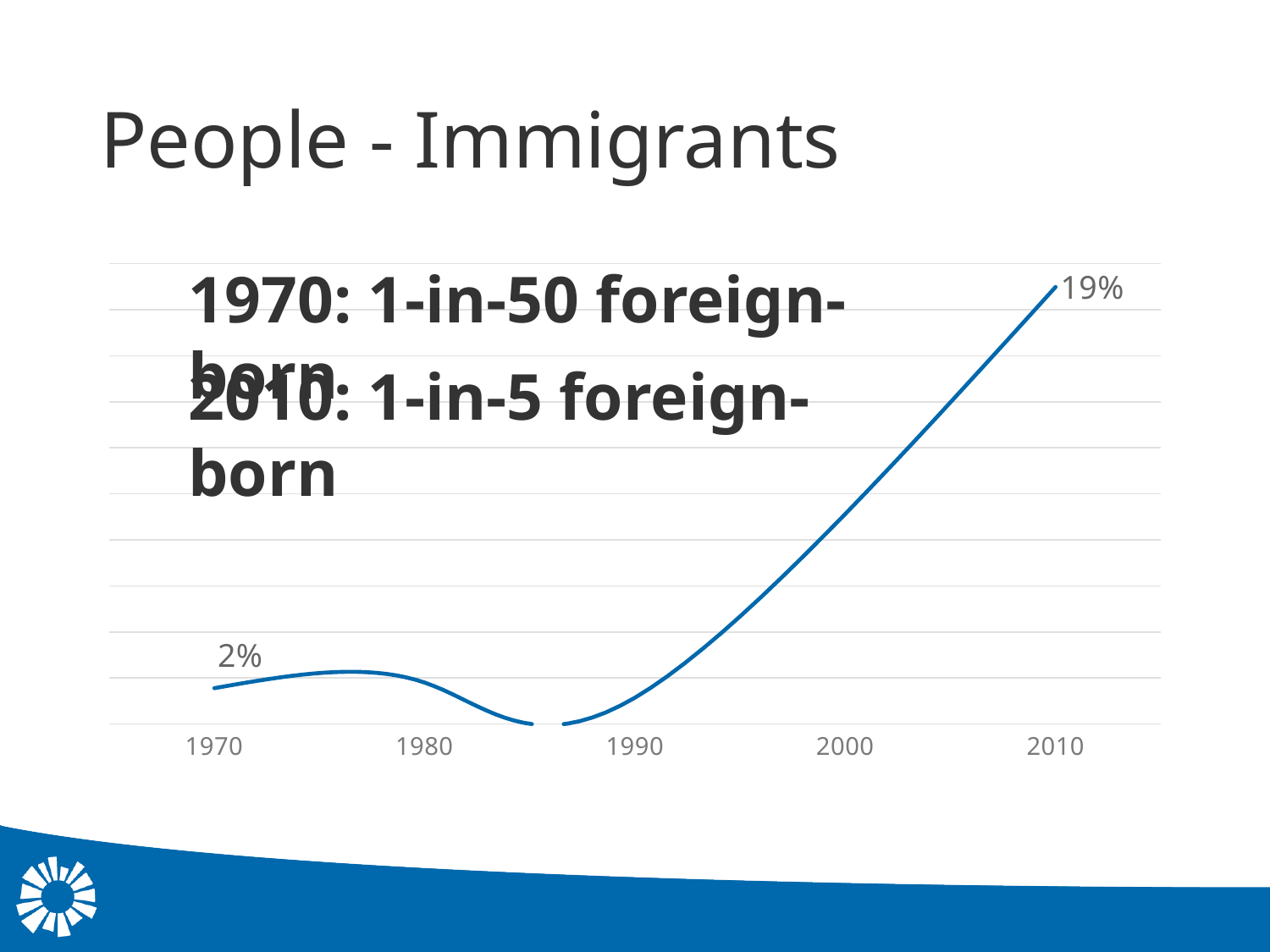
Which is larger, the value for 1970 or the value for 2010? 2010 What kind of chart is shown on the slide? Line chart What is the value shown for 2010? 19% What is the value shown for 1970? 2% What is the title of the slide containing the chart? People - Immigrants What colour is the line in the chart? Blue What is the difference between the 2010 value and the 1970 value? 17 percentage points Which year on the x axis has the highest value? 2010 How many year labels are shown on the x axis? 5 Do the values rise or fall between 1990 and 2010? Rise Which is lower, the value for 1970 or the value for 2000? 1970